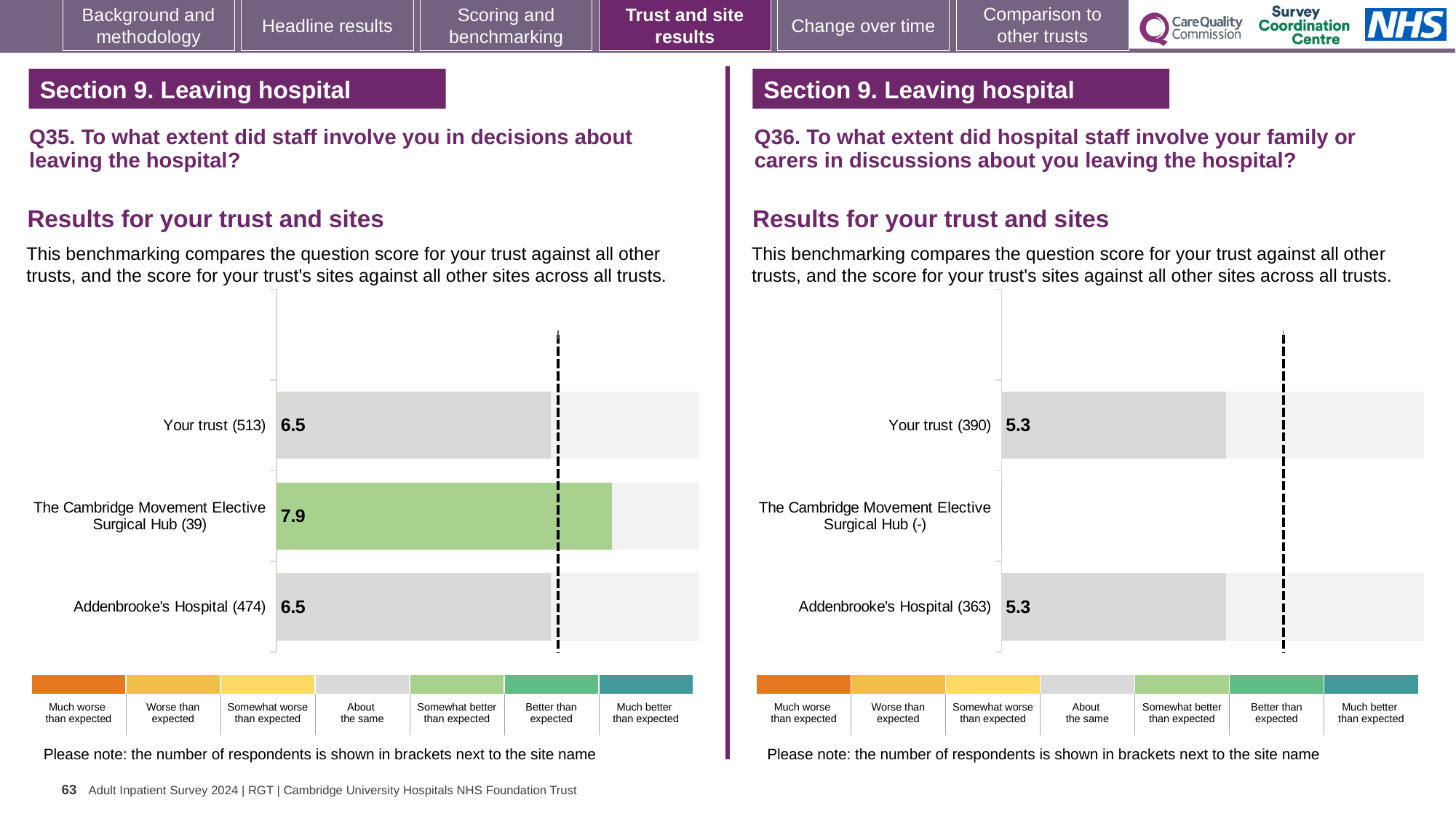
On the Q35 chart (left), what colour is the bar for The Cambridge Movement Elective Surgical Hub? Green On the Q35 chart (left), what is the difference between the score for The Cambridge Movement Elective Surgical Hub and the score for Your trust? 1.4 On the Q35 chart (left), what is the score for The Cambridge Movement Elective Surgical Hub (39)? 7.9 What kind of chart is used on the Q35 chart (left)? Bar chart On the Q35 chart (left), what is the score for Your trust (513)? 6.5 On the Q36 chart (right), how many respondents are shown for Your trust? 390 On the Q36 chart (right), what is the score for Your trust (390)? 5.3 On the Q35 chart (left), which site or trust has the highest score? The Cambridge Movement Elective Surgical Hub (39) On the Q36 chart (right), which site has no score shown? The Cambridge Movement Elective Surgical Hub (-) On the Q35 chart (left), what is the score for Addenbrooke's Hospital (474)? 6.5 On the Q36 chart (right), what is the score for Addenbrooke's Hospital (363)? 5.3 On the Q35 chart (left), how many bars are plotted? 3